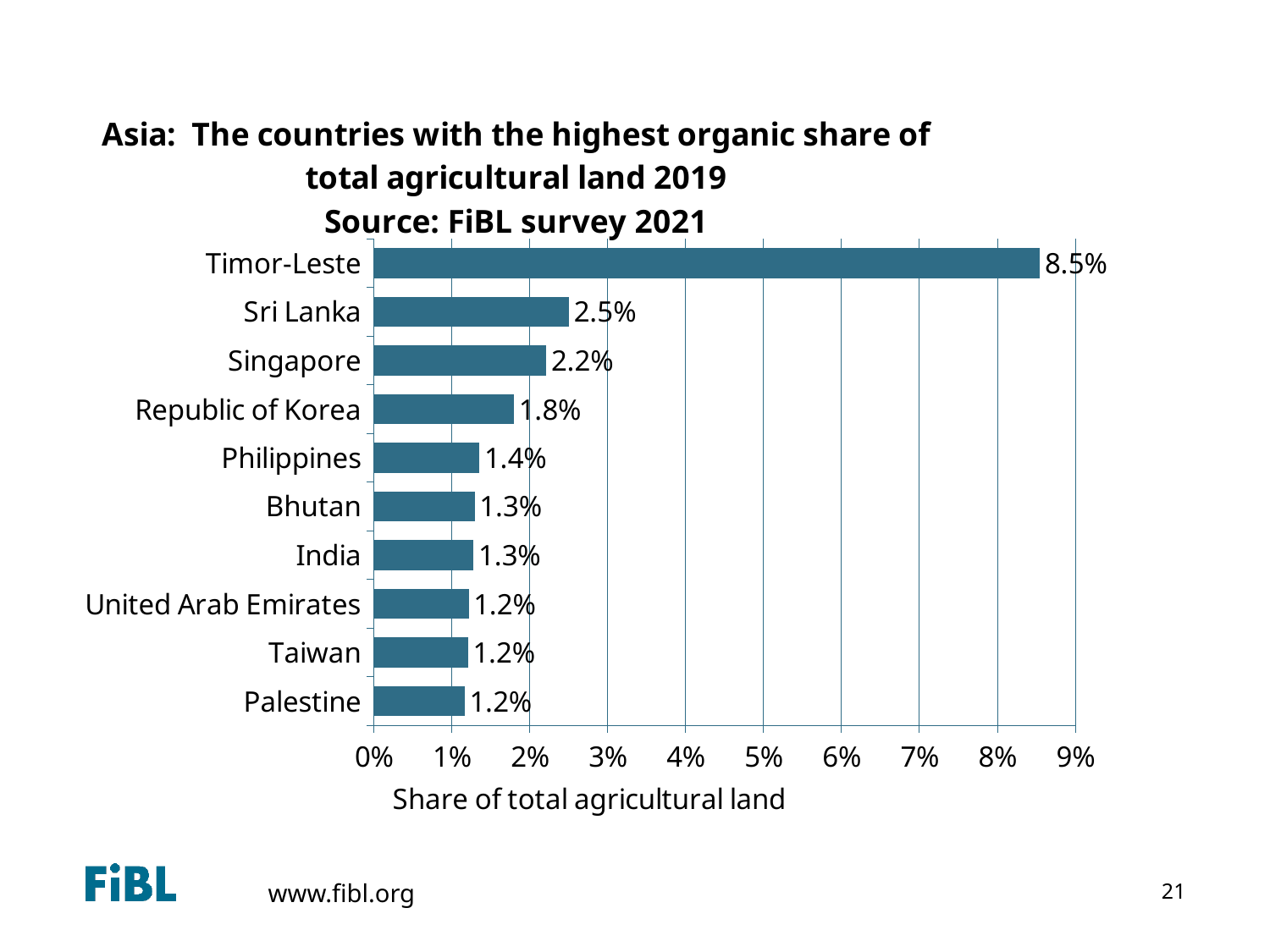
What is the organic share of total agricultural land for Philippines? 1.4% What is the organic share of total agricultural land for Timor-Leste? 8.5% How many countries are shown in the chart? 10 What kind of chart is shown on the slide? Bar chart What is the difference between the organic share of Singapore and Republic of Korea? 0.4% What is the difference between the organic share of Timor-Leste and Sri Lanka? 6.0% What is the label of the horizontal axis? Share of total agricultural land Which country has the highest organic share of total agricultural land? Timor-Leste Is the value for Timor-Leste greater or less than 8%? greater What is the organic share of total agricultural land for Republic of Korea? 1.8% What is the organic share of total agricultural land for Sri Lanka? 2.5% Which has a larger organic share of total agricultural land, Sri Lanka or Singapore? Sri Lanka